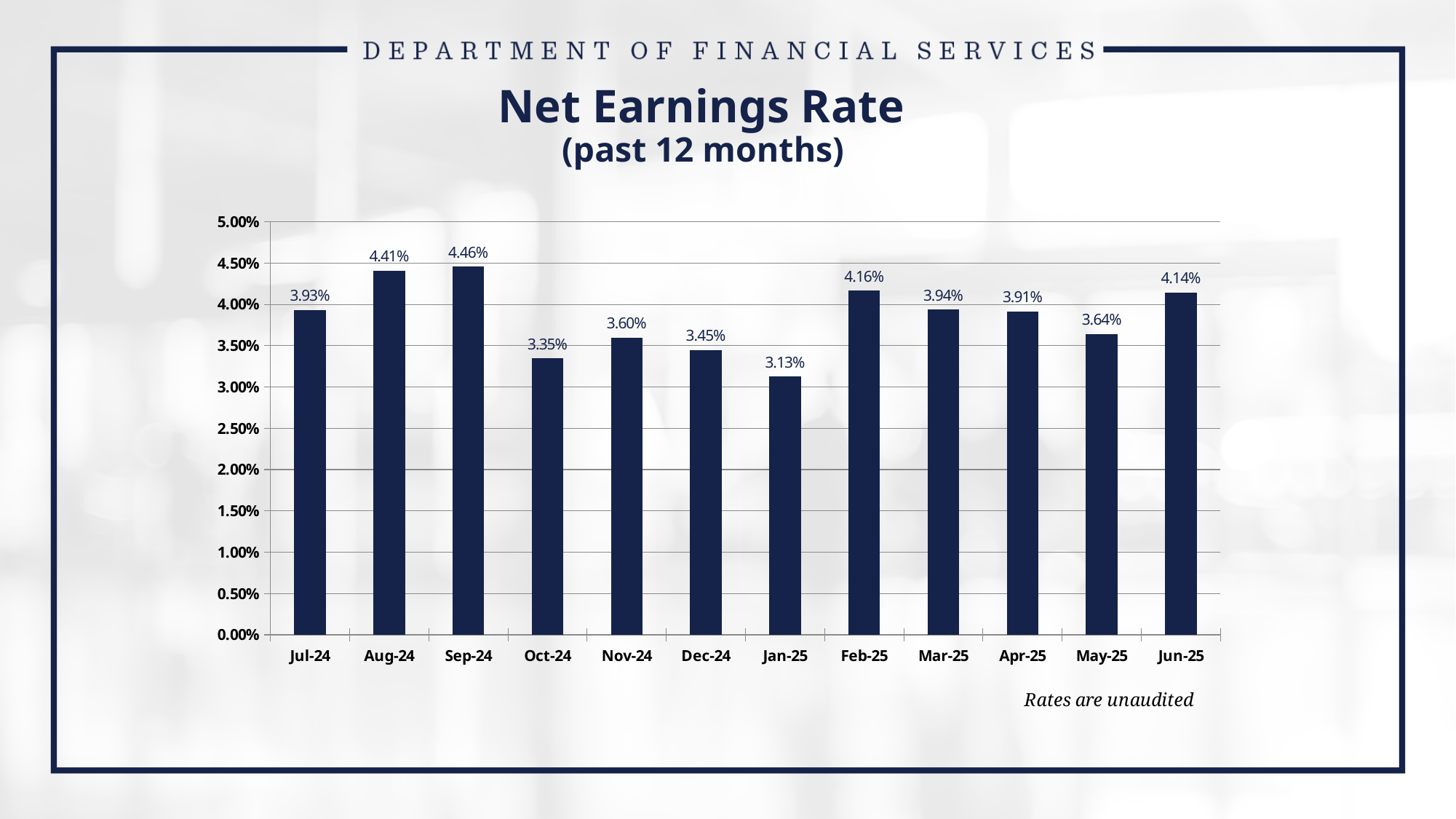
What note appears below the chart? Rates are unaudited How many months are shown on the chart? 12 Which month has the highest net earnings rate? Sep-24 What is the net earnings rate for Sep-24? 4.46% What kind of chart is shown on the slide? bar chart What is the net earnings rate for Jan-25? 3.13% Which month has the lowest net earnings rate? Jan-25 Is the value for Oct-24 greater or less than 3.50%? less What is the net earnings rate for Jun-25? 4.14% Does the net earnings rate rise or fall from Sep-24 to Oct-24? fall What is the difference between the net earnings rate for Sep-24 and Jan-25? 1.33% Which is larger, the net earnings rate for Feb-25 or Jun-25? Feb-25